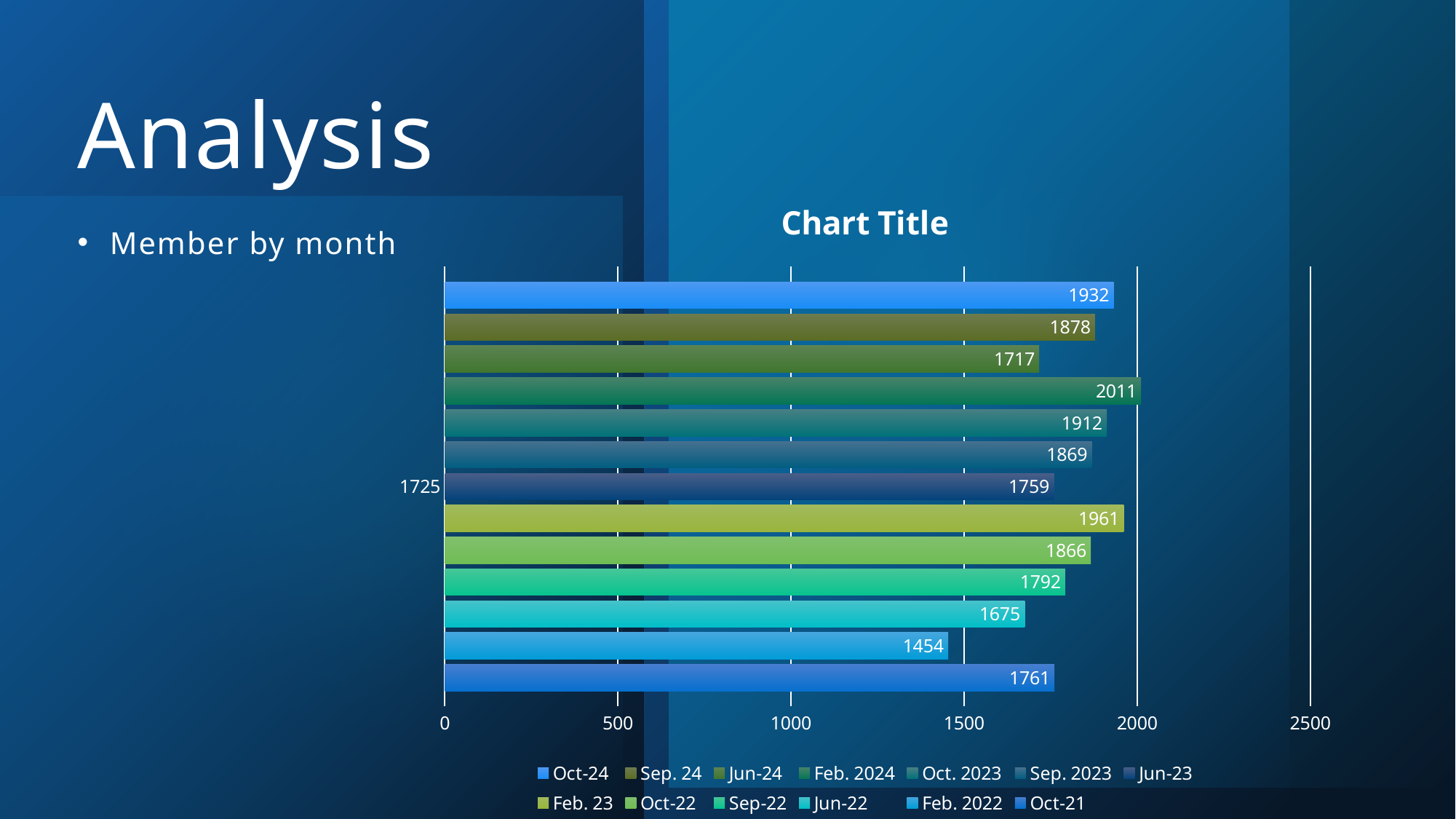
What kind of chart is shown on the slide? Bar chart Which series has the lowest value? Feb. 2022 What is the value of the Jun-23 bar? 1759 What is the difference between the Feb. 2024 value and the Feb. 2022 value? 557 What is the difference between the Oct-24 value and the Sep. 24 value? 54 Which is larger, the Feb. 23 value or the Oct-22 value? Feb. 23 Is the value for Jun-22 greater or less than 1500? greater What is the value of the Feb. 2022 bar? 1454 What is the value of the Oct-24 bar? 1932 What is the title of the chart? Chart Title How many series does the legend list? 13 Which series has the highest value? Feb. 2024